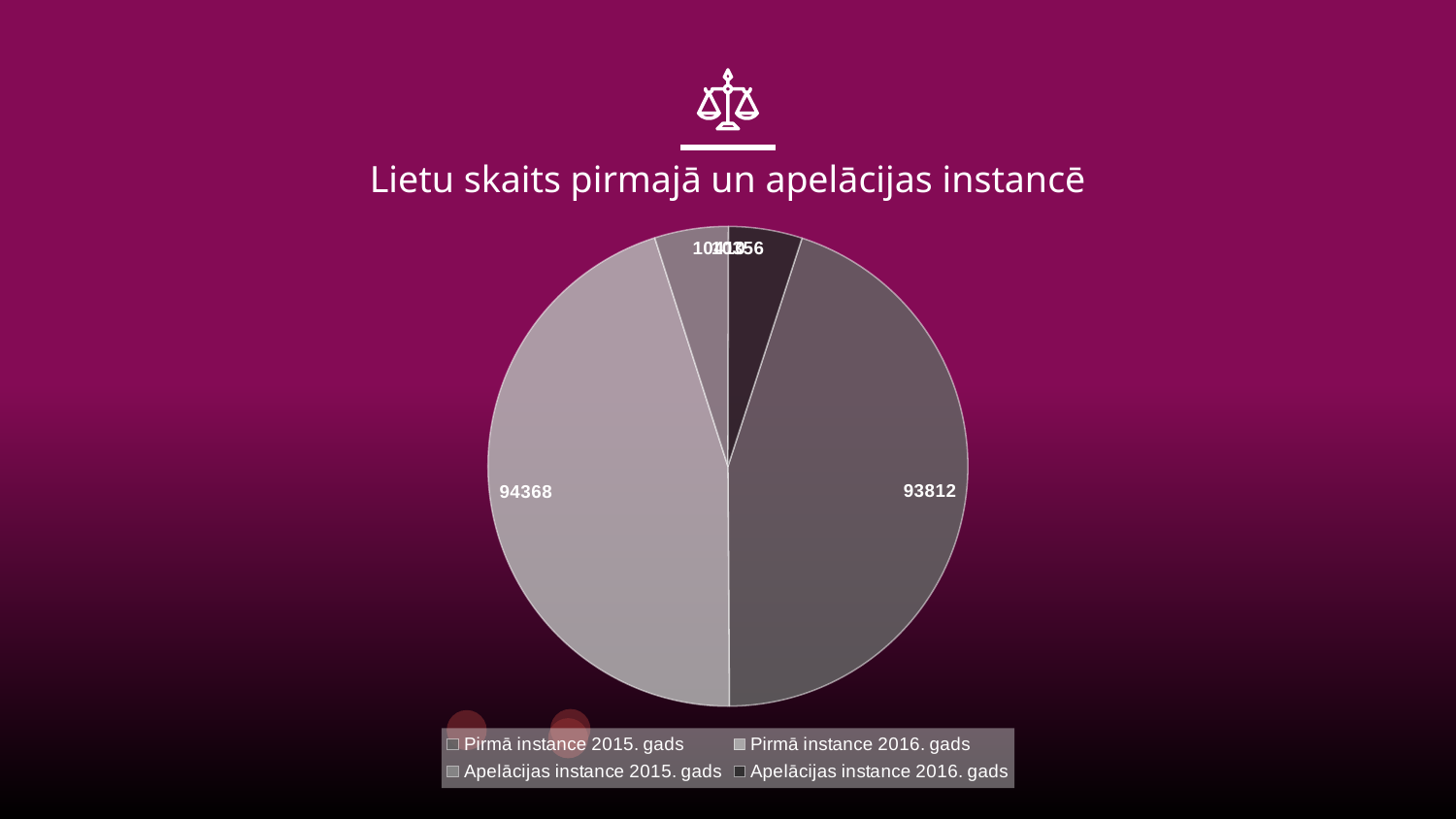
What kind of chart is shown on the slide? pie chart How many entries does the legend list? 4 Which is larger, Pirmā instance 2016. gads or Apelācijas instance 2016. gads? Pirmā instance 2016. gads What is the difference between the values for Pirmā instance 2015. gads and Pirmā instance 2016. gads? 556 What is the value for Pirmā instance 2015. gads? 93812 Which category has the largest slice in the pie chart? Pirmā instance 2016. gads What is the title of the chart? Lietu skaits pirmajā un apelācijas instancē Which legend entry is shown with the darkest colour? Apelācijas instance 2016. gads What is the value for Pirmā instance 2016. gads? 94368 How many slices does the pie chart have? 4 Which is larger, Pirmā instance 2015. gads or Pirmā instance 2016. gads? Pirmā instance 2016. gads